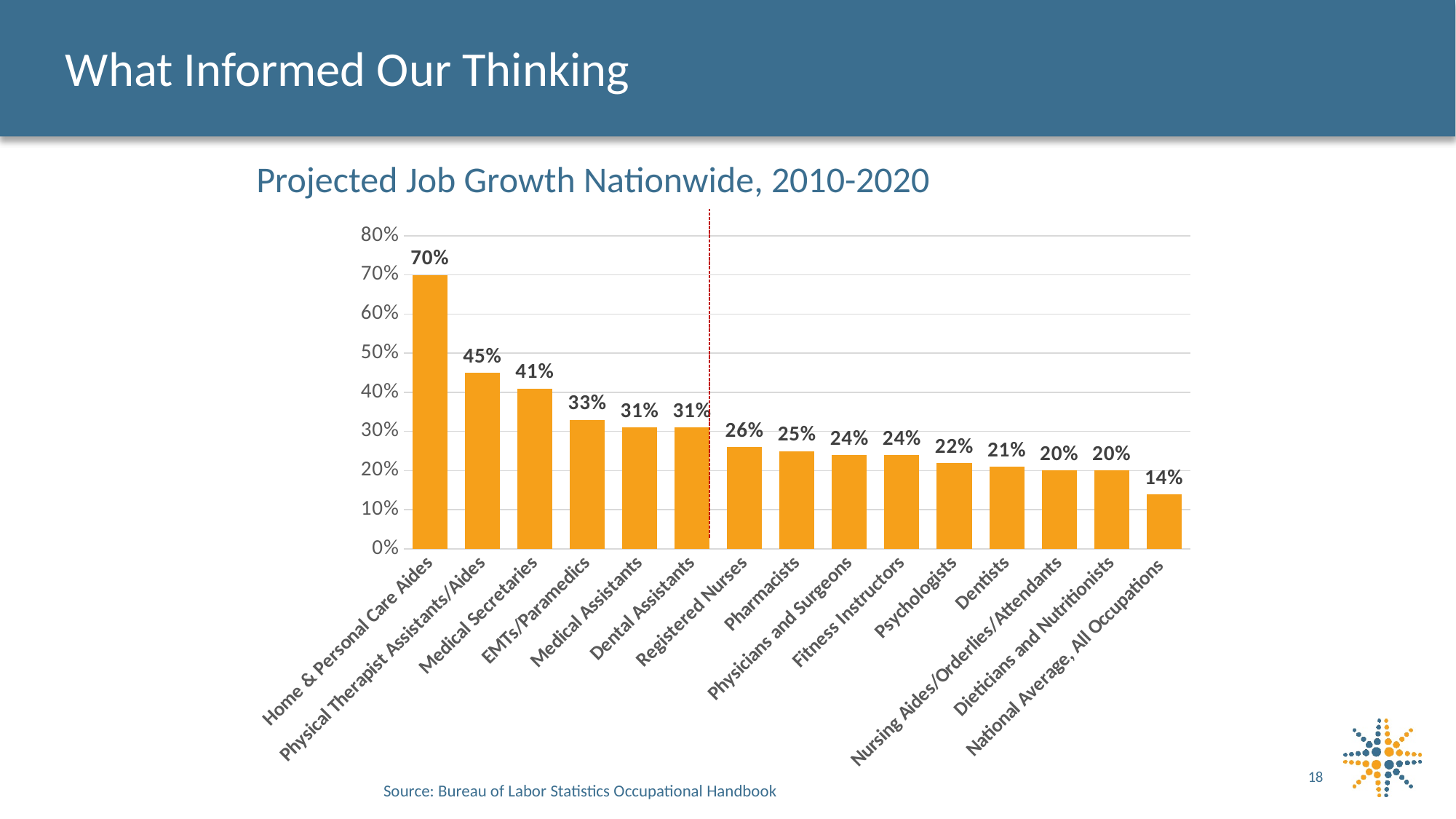
Which has higher projected job growth, Pharmacists or Psychologists? Pharmacists Do the values rise or fall from left to right along the x axis? Fall Which category has the highest projected job growth? Home & Personal Care Aides What is the difference in projected job growth between Physical Therapist Assistants/Aides and Medical Secretaries? 4% Is the value for EMTs/Paramedics greater or less than 30%? greater What is the title of the chart? Projected Job Growth Nationwide, 2010-2020 What is the projected job growth for Home & Personal Care Aides? 70% What is the projected job growth for the National Average, All Occupations? 14% Which category has the lowest projected job growth? National Average, All Occupations What kind of chart is shown on the slide? Bar chart How many categories are shown in the chart? 15 What is the projected job growth for Registered Nurses? 26%